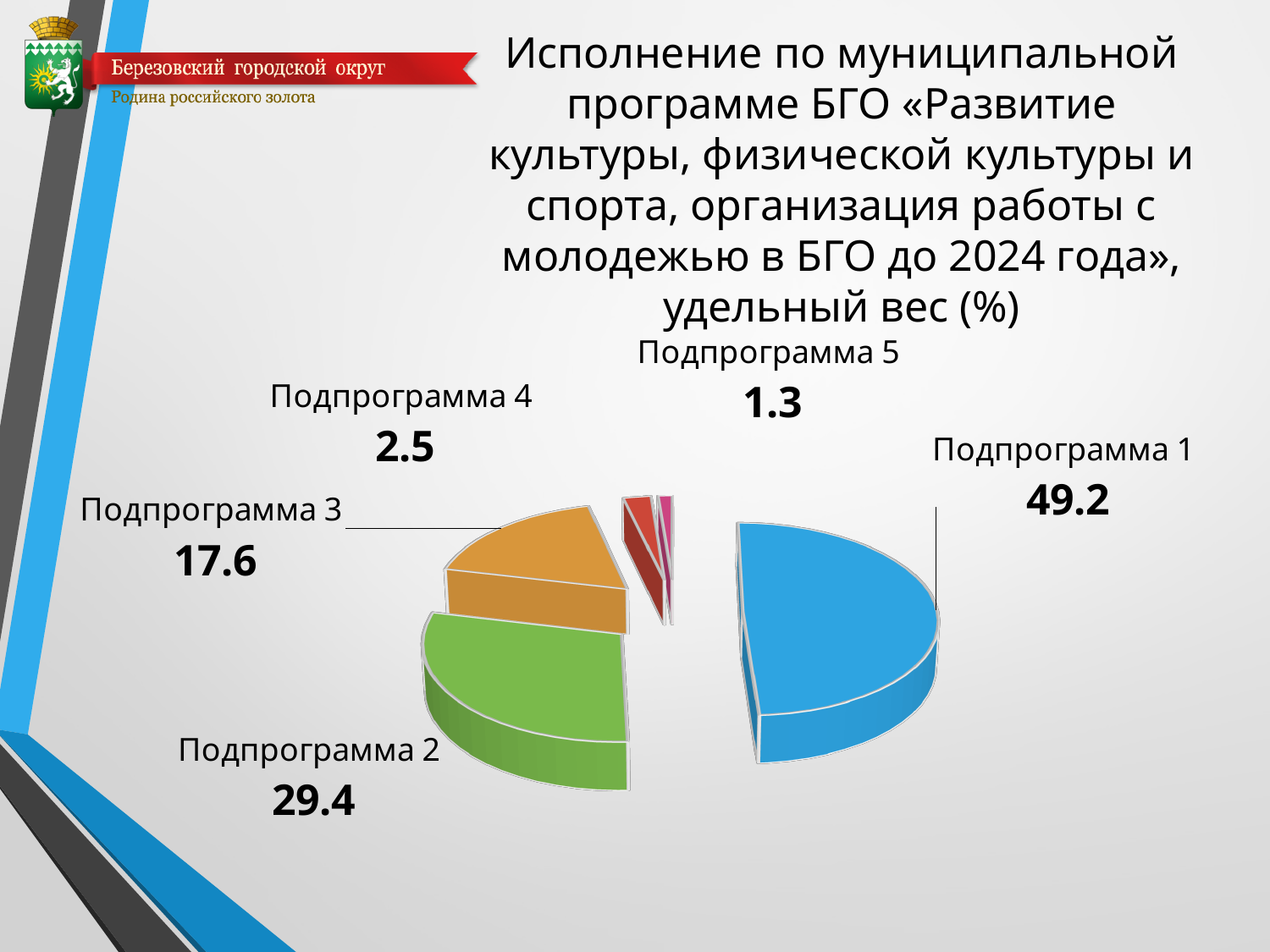
What is the difference between the values for Подпрограмма 1 and Подпрограмма 2? 19.8 Which subprogram has the smallest share? Подпрограмма 5 What value is shown for Подпрограмма 4? 2.5 What value is shown for Подпрограмма 1? 49.2 What value is shown for Подпрограмма 3? 17.6 What value is shown for Подпрограмма 5? 1.3 What kind of chart is shown on the slide? Pie chart How many slices does the pie chart have? 5 What value is shown for Подпрограмма 2? 29.4 What colour is the slice for Подпрограмма 2? Green Which subprogram has the largest share? Подпрограмма 1 Which is larger, the value for Подпрограмма 3 or Подпрограмма 4? Подпрограмма 3